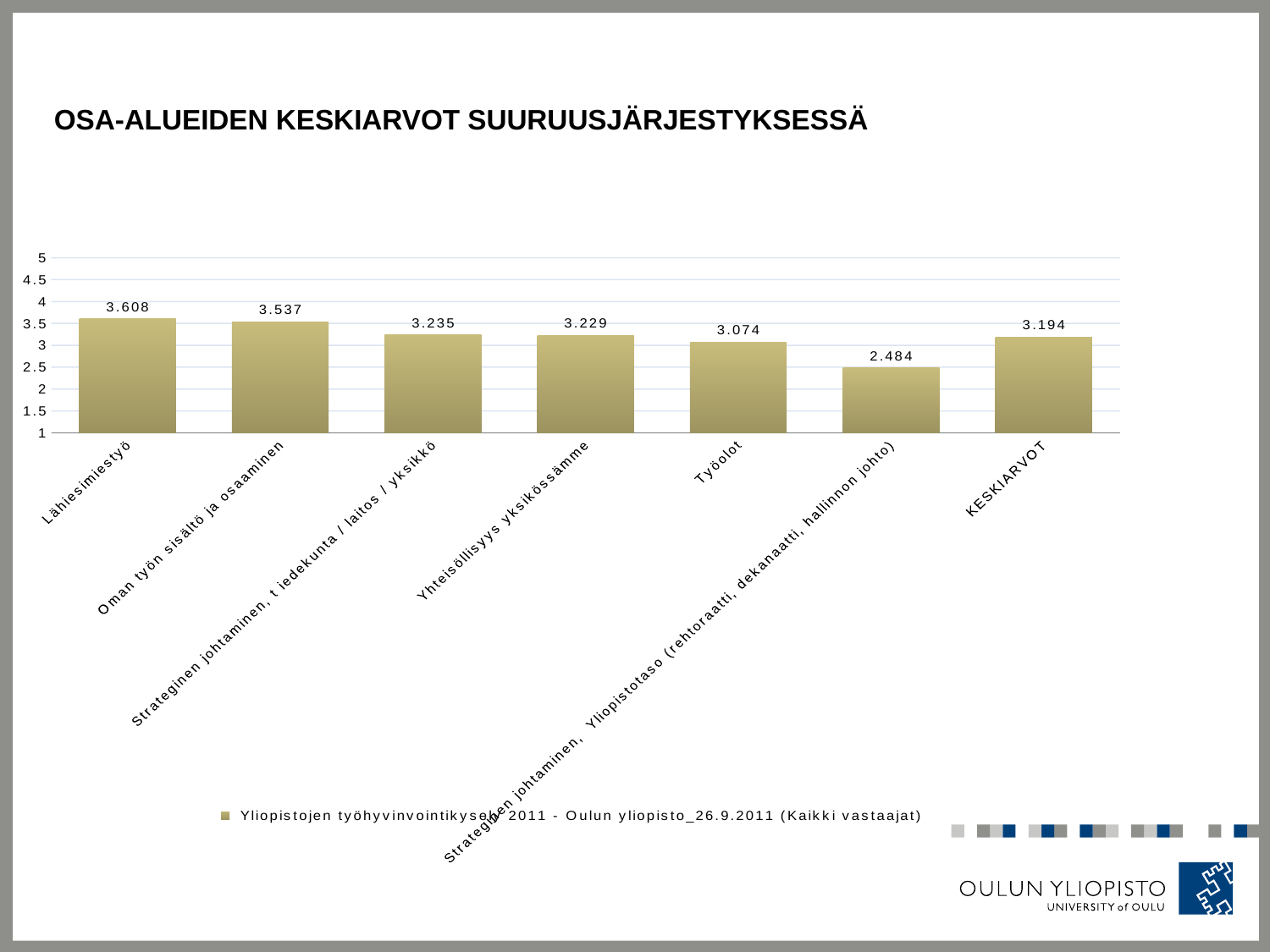
Which category has the highest value? Lähiesimiestyö Which is larger, the value for Oman työn sisältö ja osaaminen or the value for Yhteisöllisyys yksikössämme? Oman työn sisältö ja osaaminen What kind of chart is shown on the slide? bar chart Is the value for Strateginen johtaminen, Yliopistotaso (rehtoraatti, dekanaatti, hallinnon johto) greater or less than 3? less What is the value for KESKIARVOT? 3.194 What is the value for Työolot? 3.074 How many bars are shown in the chart? 7 Which category has the lowest value? Strateginen johtaminen, Yliopistotaso (rehtoraatti, dekanaatti, hallinnon johto) What is the value for Oman työn sisältö ja osaaminen? 3.537 What is the value for Lähiesimiestyö? 3.608 What is the title of the slide? OSA-ALUEIDEN KESKIARVOT SUURUUSJÄRJESTYKSESSÄ What is the difference between the values for Lähiesimiestyö and Työolot? 0.534